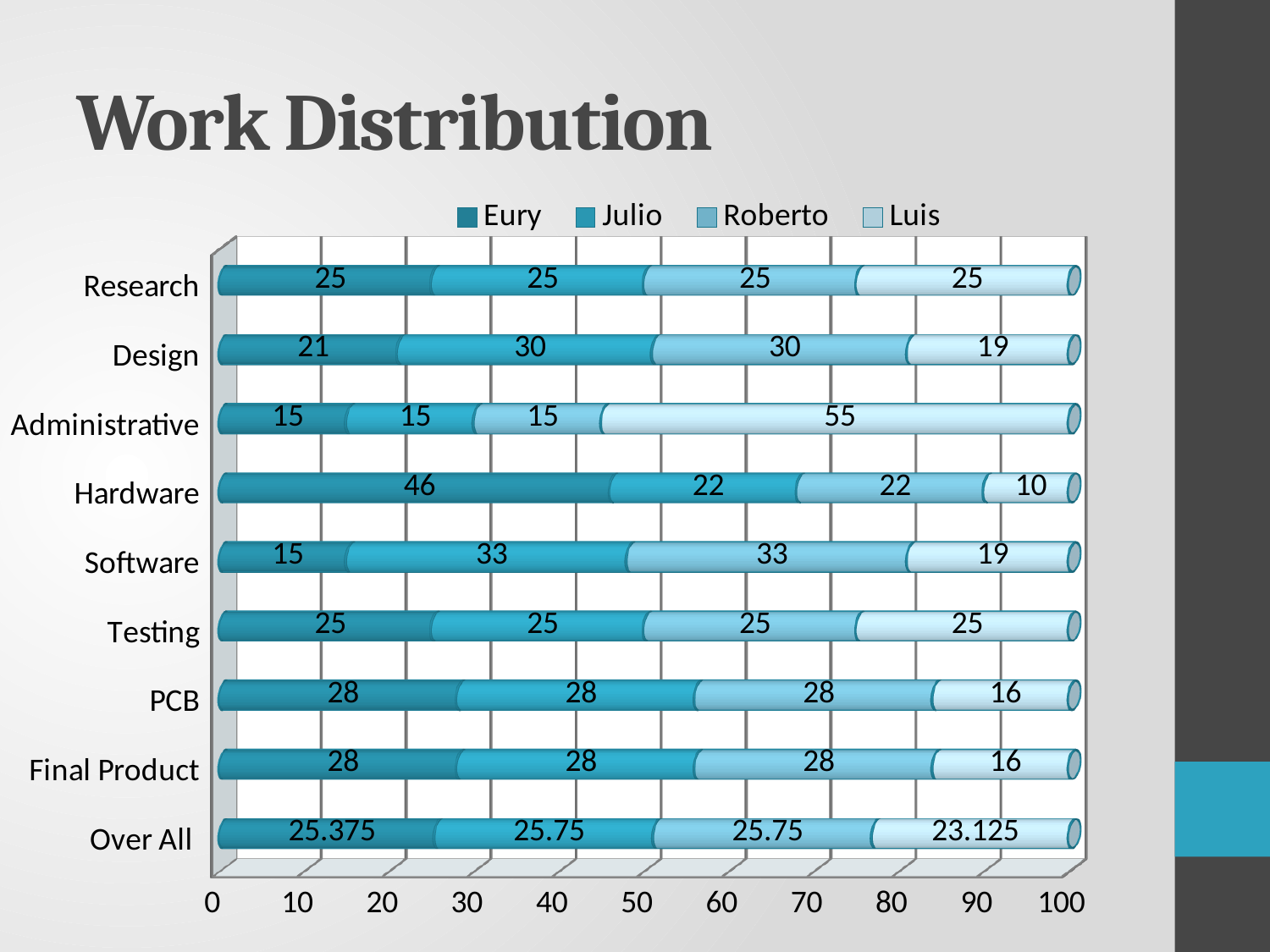
Which category has the highest value for Luis? Administrative What is Eury's value for Hardware? 46 Which is larger: Julio's value for Design or Julio's value for Administrative? Design What is Luis's value for Administrative? 55 How many series does the legend list? 4 What is the difference between Eury's value for Hardware and Eury's value for Software? 31 What is Luis's value for PCB? 16 What is Roberto's value for Over All? 25.75 What is the total of the stacked bar for Design? 100 How many categories are shown on the y axis? 9 Which category has the lowest value for Luis? Hardware What kind of chart is shown on the slide? Stacked bar chart